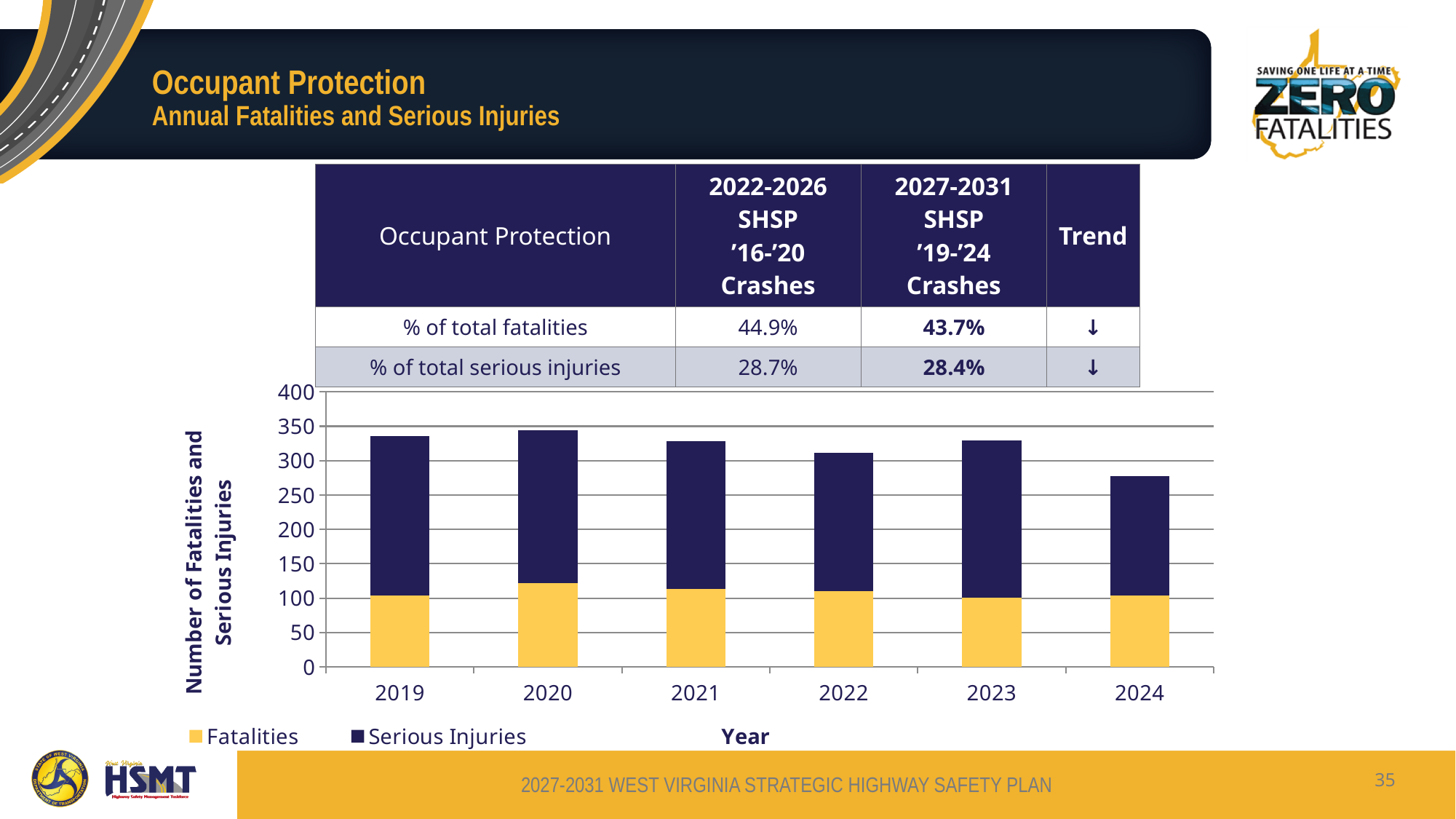
Which series is shown in yellow in the chart? Fatalities How many series does the chart legend list? 2 Which year has the highest Fatalities value? 2020 Which year has the lowest total of fatalities and serious injuries? 2024 Which is larger, the total bar for 2022 or the total bar for 2024? 2022 Is the total bar for 2019 greater or less than 350? less What is the title of the y axis of the chart? Number of Fatalities and Serious Injuries Is the total bar for 2024 greater or less than 300? less Is the Fatalities value for 2020 greater or less than 100? greater What kind of chart is shown on the slide? Stacked bar chart How many years are shown on the x axis of the chart? 6